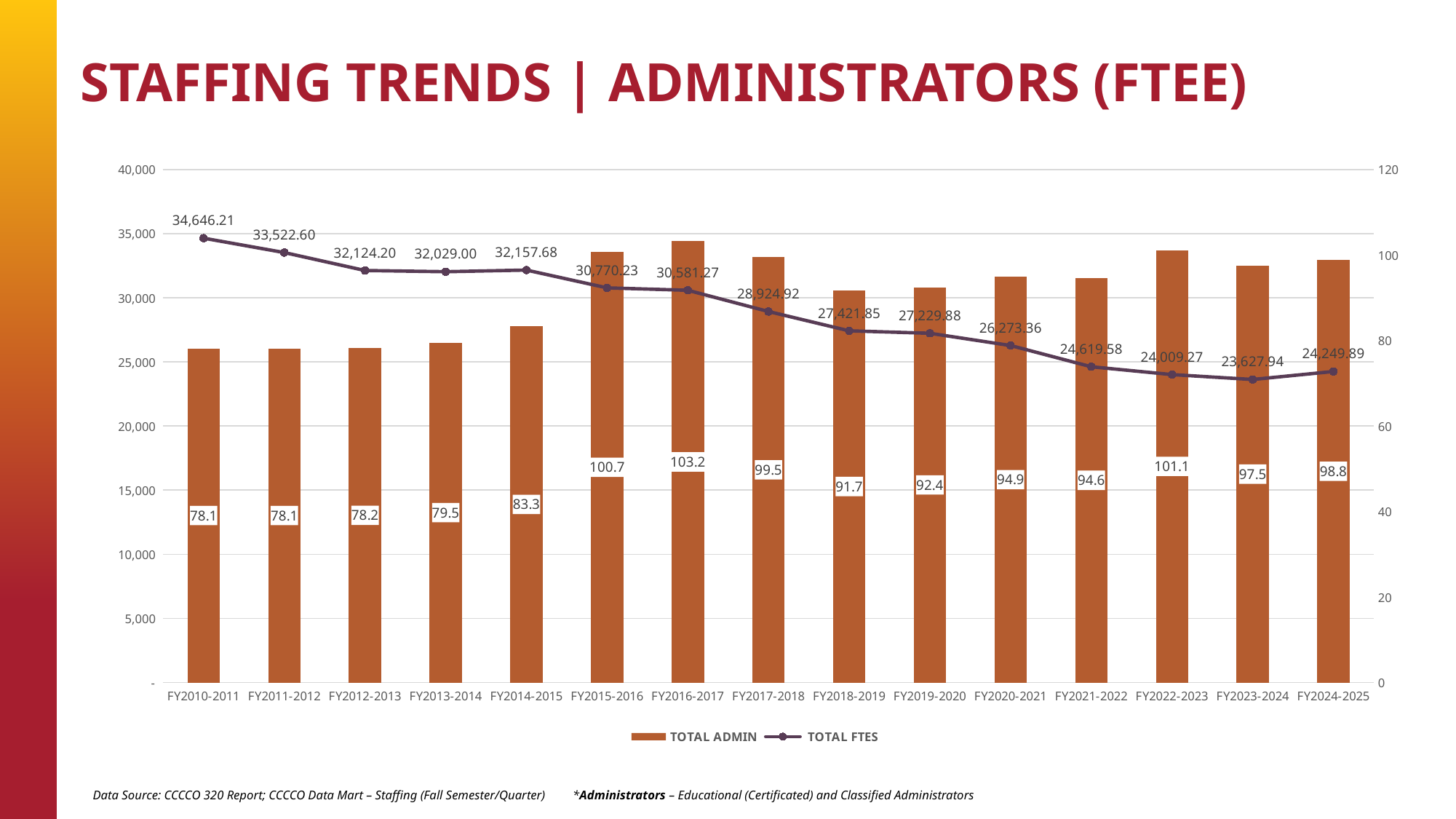
Which fiscal year has the highest TOTAL ADMIN value? FY2016-2017 How many fiscal years are shown on the x axis? 15 Does the TOTAL FTES line rise or fall from FY2010-2011 to FY2023-2024? Fall What is the TOTAL ADMIN value for FY2016-2017? 103.2 Which has the larger TOTAL ADMIN value, FY2022-2023 or FY2023-2024? FY2022-2023 What is the difference between the TOTAL ADMIN values for FY2016-2017 and FY2010-2011? 25.1 What kind of chart is shown on the slide? A bar chart combined with a line chart How many series does the legend list? 2 What is the TOTAL FTES value for FY2024-2025? 24,249.89 What is the TOTAL FTES value for FY2010-2011? 34,646.21 What is the difference between the TOTAL FTES values for FY2010-2011 and FY2024-2025? 10,396.32 Which fiscal year has the lowest TOTAL FTES value? FY2023-2024